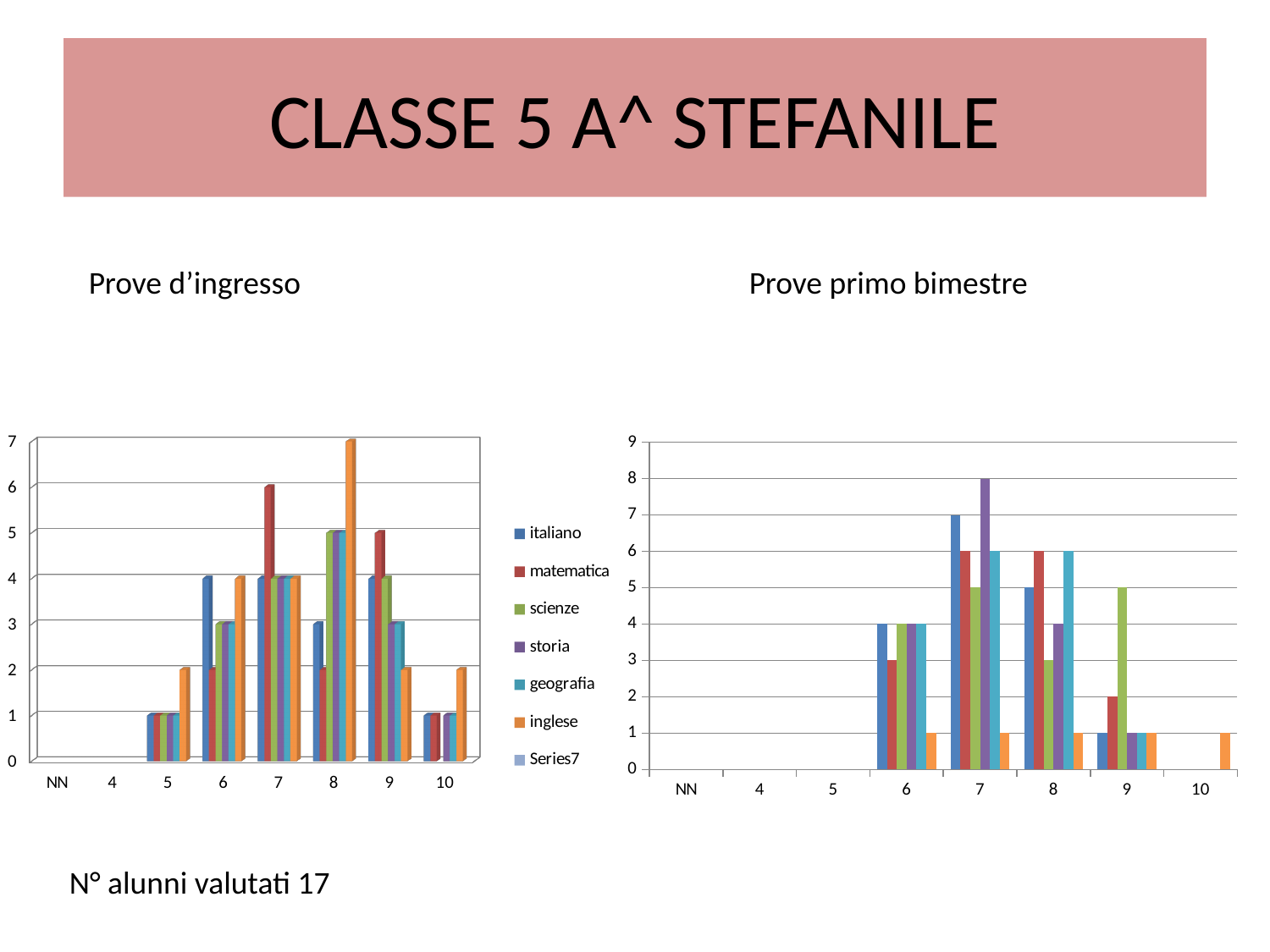
In the 'Prove primo bimestre' chart, what is the value for storia at grade 7? 8 What kind of chart is the 'Prove primo bimestre' chart? bar chart In the 'Prove d'ingresso' chart, which series has the tallest bar overall? inglese In the 'Prove d'ingresso' chart, is the value for inglese at grade 8 greater or less than 5? greater In the 'Prove primo bimestre' chart, which series has the tallest bar overall? storia How many series does the legend list? 7 In the 'Prove primo bimestre' chart, at grade 9, which is larger: scienze or matematica? scienze In the 'Prove primo bimestre' chart, what is the value for italiano at grade 7? 7 What is the highest value shown on the y axis of the 'Prove primo bimestre' chart? 9 In the 'Prove primo bimestre' chart, what is the value for scienze at grade 9? 5 In the 'Prove primo bimestre' chart, what is the difference between storia and italiano at grade 7? 1 In the 'Prove primo bimestre' chart, how many categories are shown on the x axis? 8